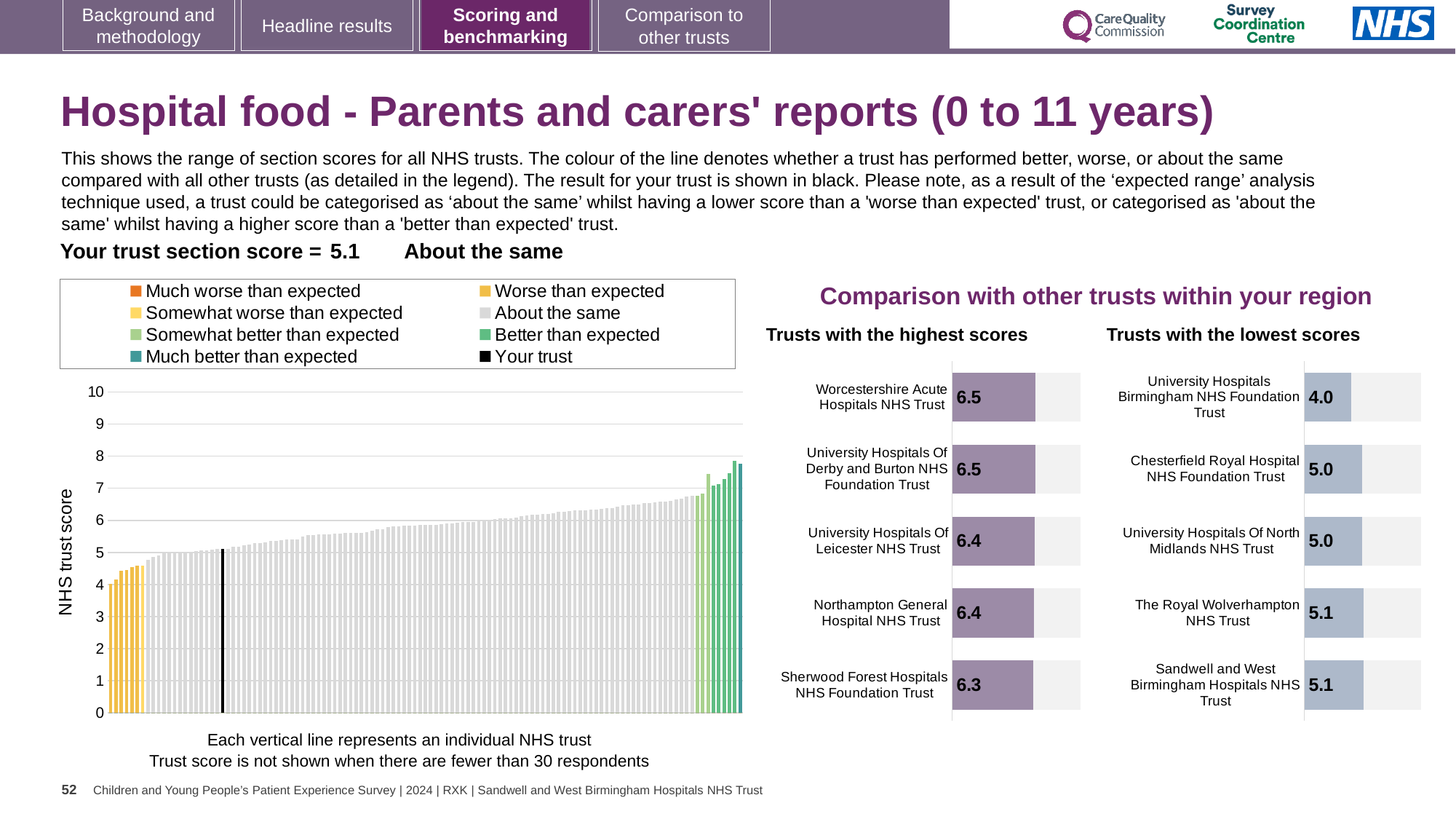
On the 'Trusts with the highest scores' chart, what is the score for Worcestershire Acute Hospitals NHS Trust? 6.5 On the 'Trusts with the lowest scores' chart, which has the larger score: Chesterfield Royal Hospital NHS Foundation Trust or The Royal Wolverhampton NHS Trust? The Royal Wolverhampton NHS Trust On the 'Trusts with the highest scores' chart, what is the difference between the scores of Worcestershire Acute Hospitals NHS Trust and Sherwood Forest Hospitals NHS Foundation Trust? 0.2 On the 'Trusts with the lowest scores' chart, which trust has the lowest score? University Hospitals Birmingham NHS Foundation Trust On the large chart on the left, do the trust scores rise or fall from left to right? Rise On the 'Trusts with the lowest scores' chart, what is the score for University Hospitals Birmingham NHS Foundation Trust? 4.0 On the 'Trusts with the lowest scores' chart, what is the difference between the scores of Sandwell and West Birmingham Hospitals NHS Trust and University Hospitals Birmingham NHS Foundation Trust? 1.1 On the 'Trusts with the highest scores' chart, what is the score for Sherwood Forest Hospitals NHS Foundation Trust? 6.3 What kind of chart is the large chart on the left of the slide showing NHS trust scores? Bar chart On the 'Trusts with the highest scores' chart, how many trusts are shown? 5 How many entries does the legend above the large chart on the left list? 8 On the 'Trusts with the highest scores' chart, which trust has the lowest score? Sherwood Forest Hospitals NHS Foundation Trust